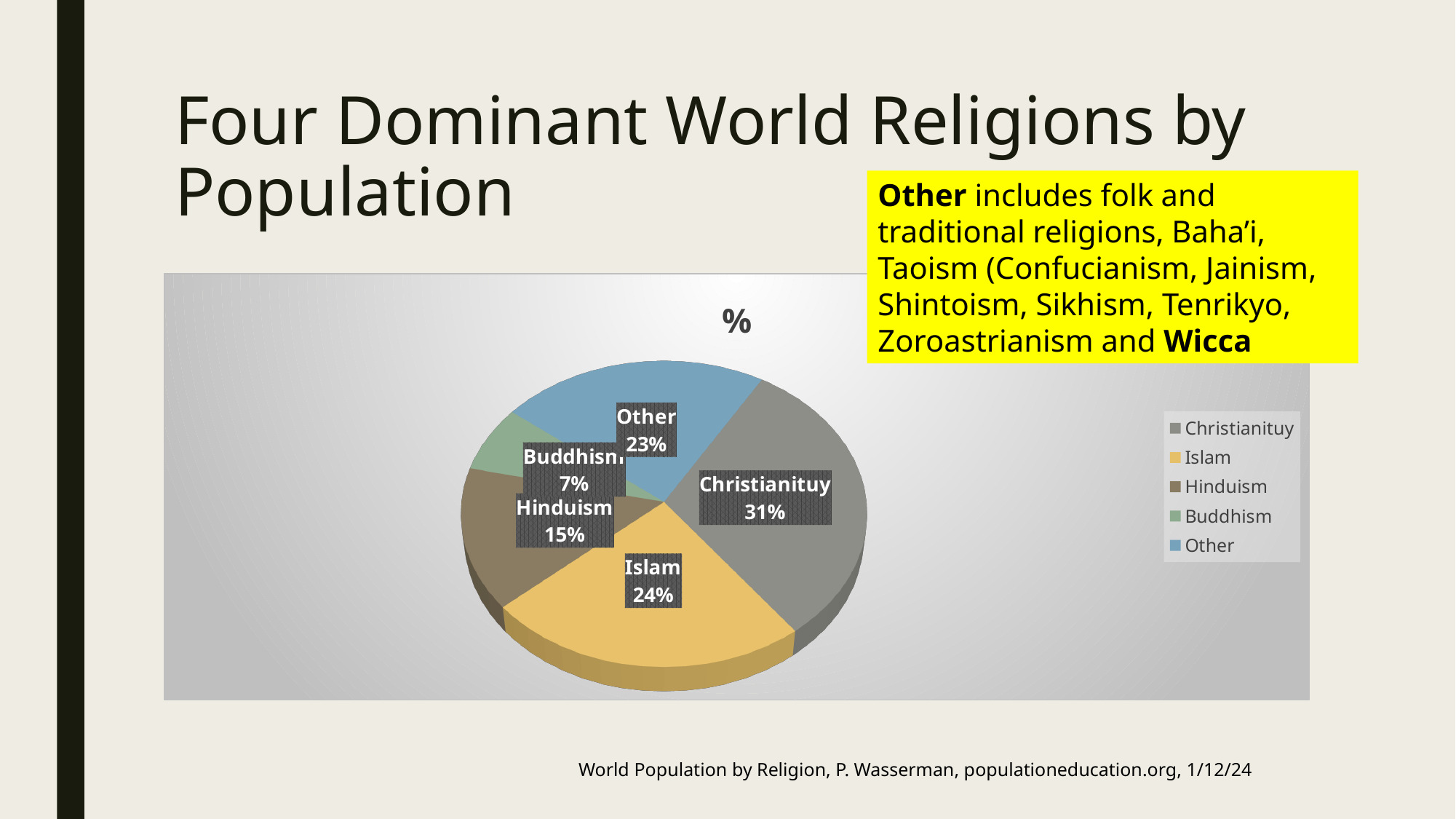
What percentage does the Hinduism slice show? 15% Which slice of the pie chart is the smallest? Buddhism What percentage does the Christianituy slice show? 31% Which slice of the pie chart is the largest? Christianituy What is the title shown above the pie chart? % What percentage does the Islam slice show? 24% What type of chart is shown on the slide? pie chart What percentage does the Buddhism slice show? 7% What percentage does the Other slice show? 23% How many slices does the pie chart have? 5 What is the difference in percentage points between the Christianituy slice and the Islam slice? 7 Which is larger, the Islam slice or the Other slice? Islam